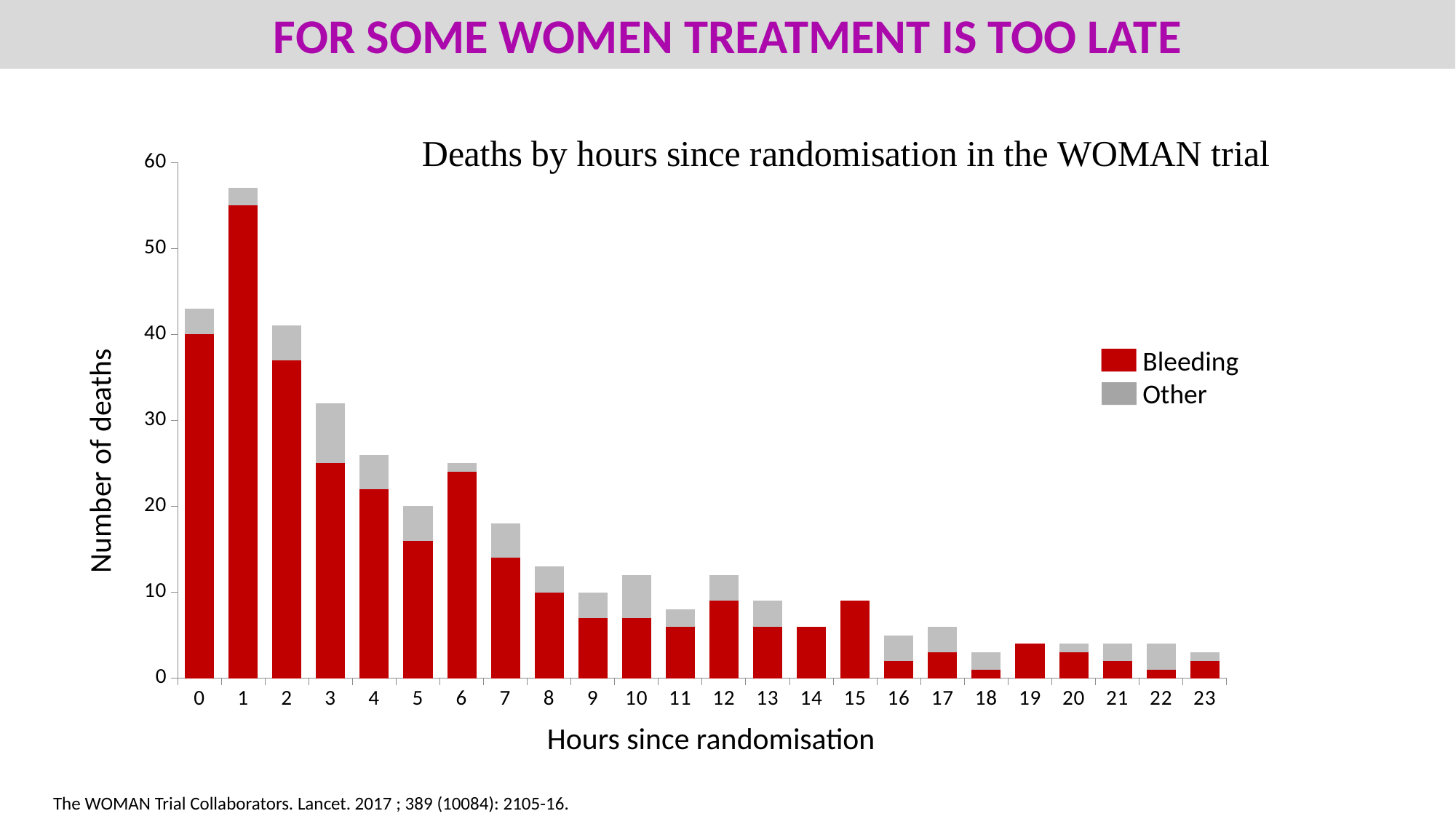
Overall, do the total deaths rise or fall as hours since randomisation increase? fall How many hour categories are shown on the x axis? 24 At which hour since randomisation is the number of Bleeding deaths highest? 1 Which has more total deaths, hour 3 or hour 6? hour 3 Is the total number of deaths at hour 1 greater or less than 50? greater What is the title of the chart? Deaths by hours since randomisation in the WOMAN trial Is the total number of deaths at hour 0 greater or less than 40? greater How many series does the legend list? 2 Is the number of Bleeding deaths at hour 2 greater or less than 40? less What kind of chart is shown on the slide? bar chart At which hour since randomisation is the total number of deaths highest? 1